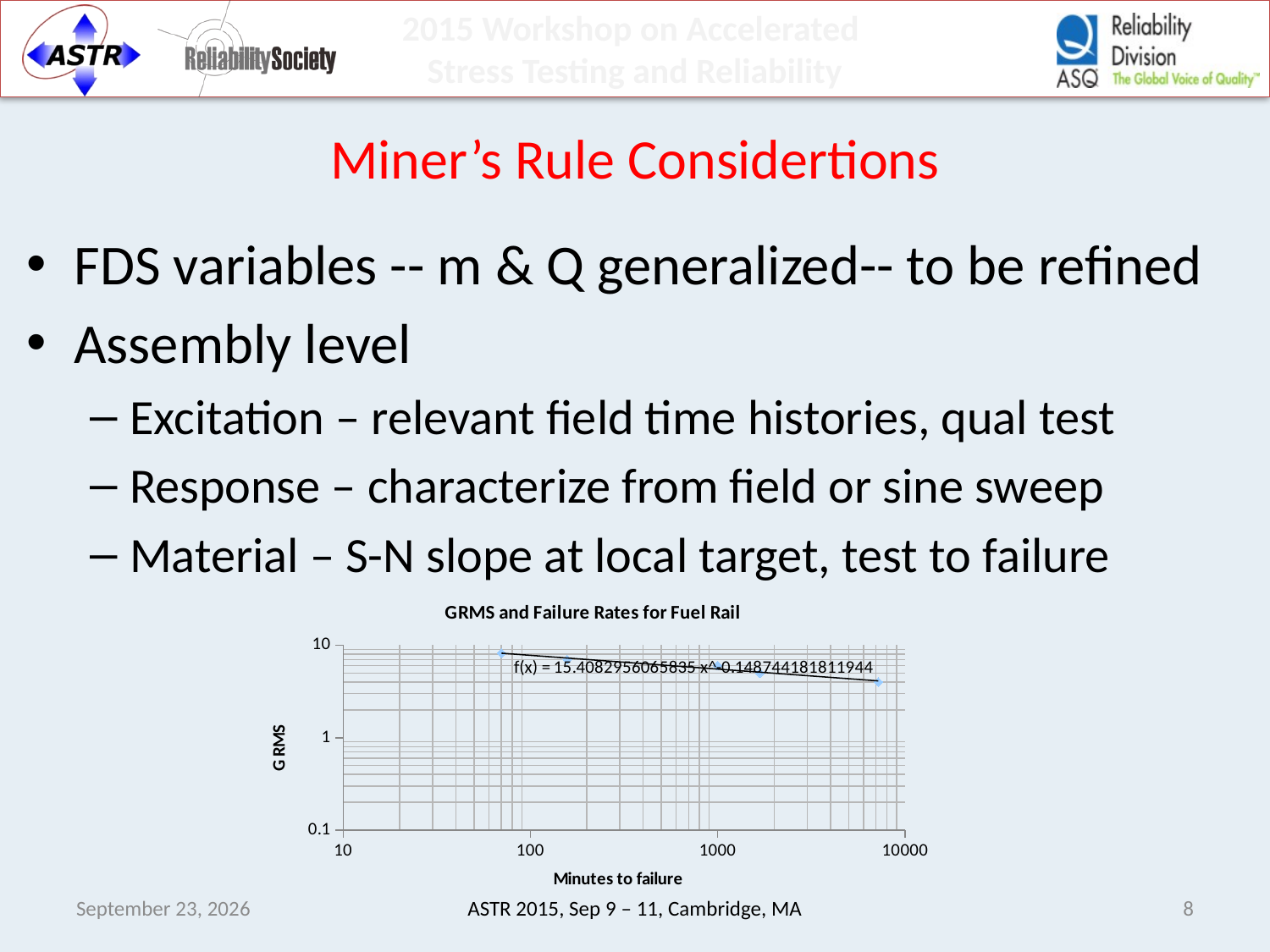
What is the highest tick value shown on the x axis of the chart? 10000 Is the GRMS value for the point with the shortest time to failure greater or less than 10? less What is the trendline equation printed on the chart? f(x) = 15.4082956065835 x^-0.148744181811944 Which has the higher GRMS value: the point with the shortest time to failure or the point with the longest time to failure? the point with the shortest time to failure What is the lowest tick value shown on the y axis of the chart? 0.1 What is the label of the x axis of the chart? Minutes to failure Do the GRMS values rise or fall as minutes to failure increase along the x axis? fall What kind of chart is shown on the slide? scatter chart Is the GRMS value for the point with the longest time to failure greater or less than 1? greater What is the title of the chart on the slide? GRMS and Failure Rates for Fuel Rail Is the GRMS value for the point with the shortest time to failure greater or less than 1? greater